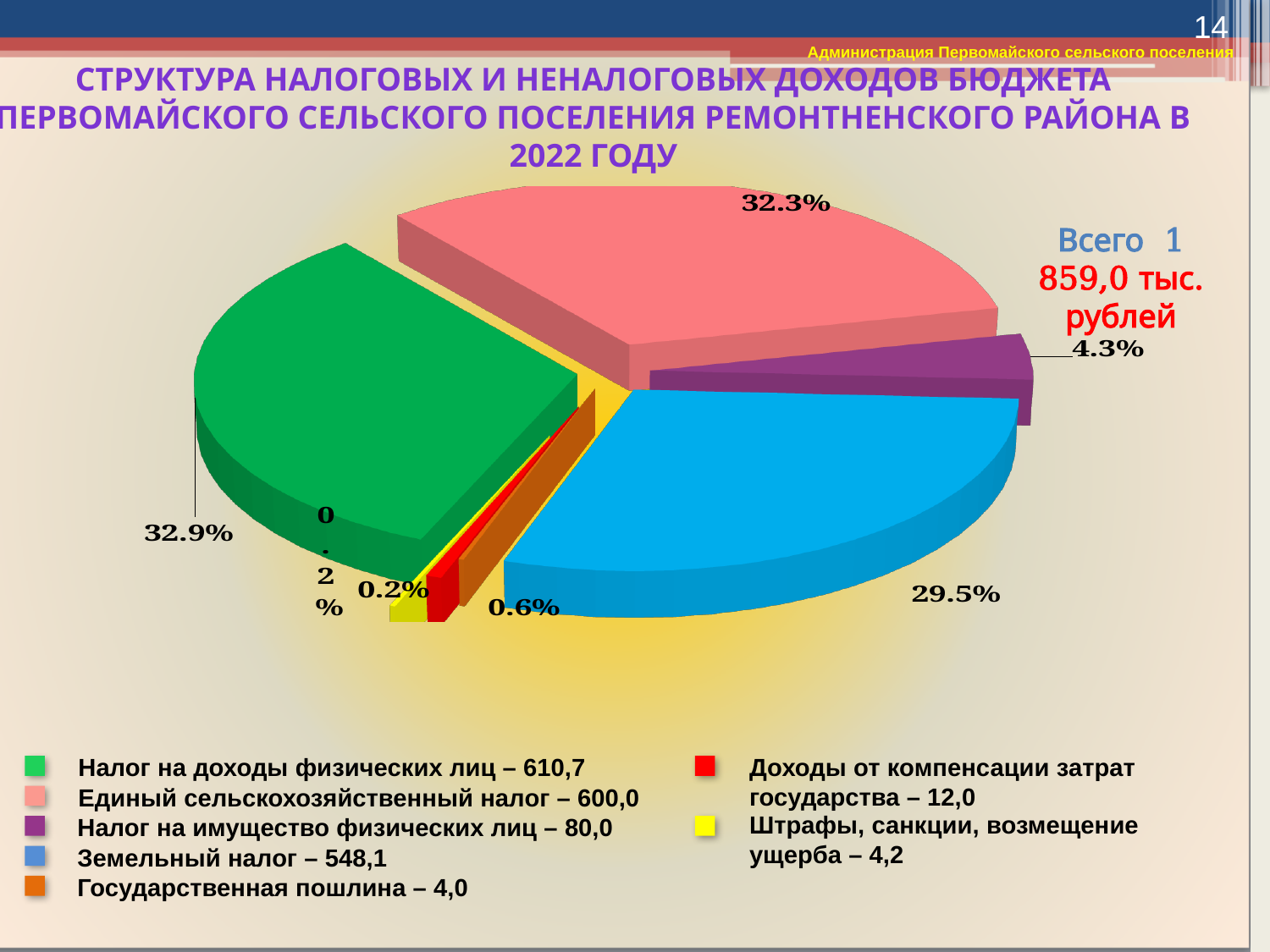
What is the difference between the legend values for Налог на доходы физических лиц and Единый сельскохозяйственный налог? 10,7 What share of the pie does the green slice (Налог на доходы физических лиц) represent? 32.9% How many categories does the legend of the pie chart list? 7 What value does the legend give for Земельный налог? 548,1 What share of the pie does the pink slice (Единый сельскохозяйственный налог) represent? 32.3% Which category has the largest share of the pie? Налог на доходы физических лиц What total amount is stated next to the pie chart? 1 859,0 тыс. рублей What value does the legend give for Доходы от компенсации затрат государства? 12,0 What kind of chart is shown on the slide? pie chart What share of the pie does the blue slice (Земельный налог) represent? 29.5% Which is larger: the share for Единый сельскохозяйственный налог or the share for Земельный налог? Единый сельскохозяйственный налог